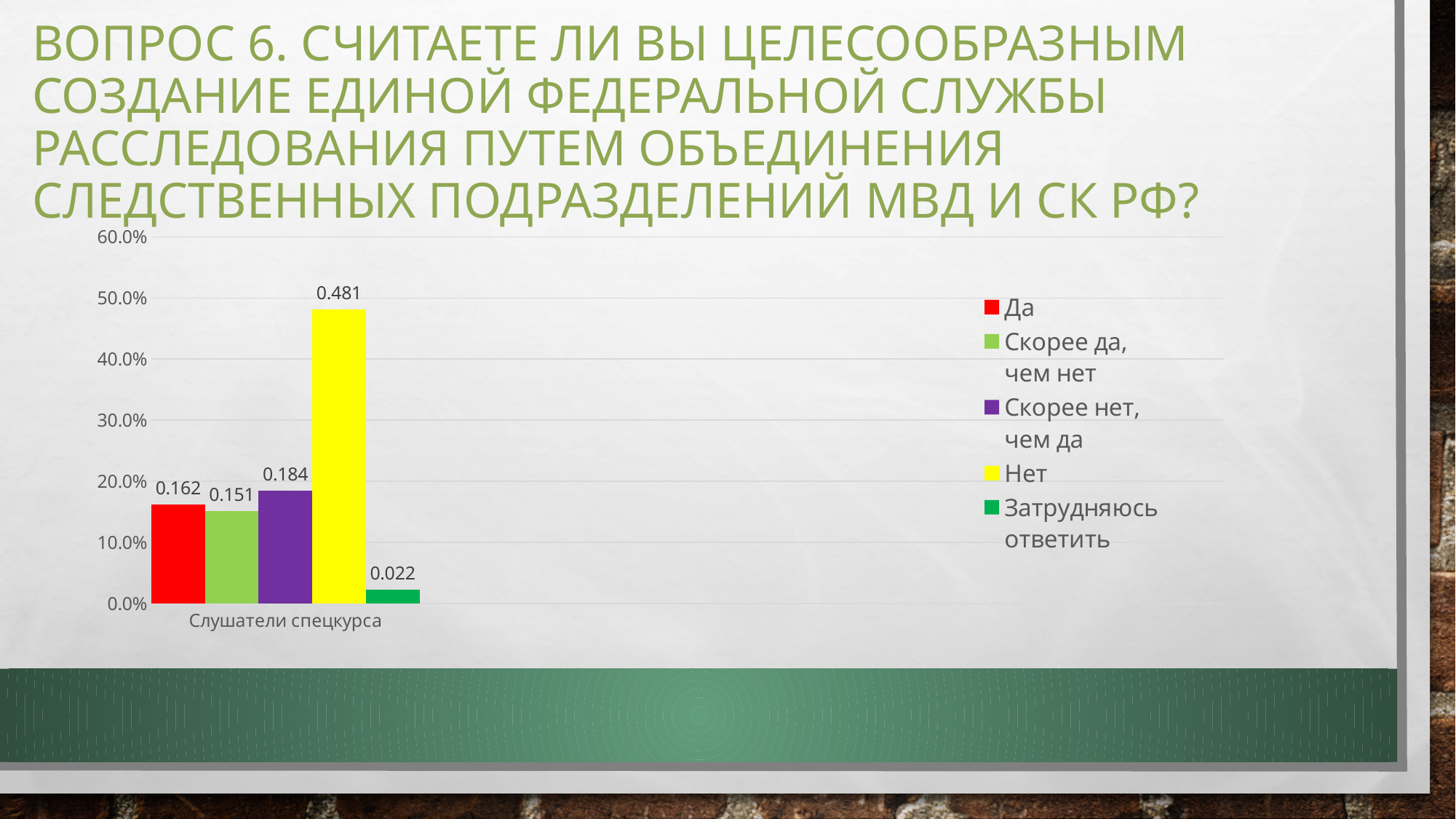
Which response has the lowest value? Затрудняюсь ответить Which response has the highest value? Нет How many series does the legend list? 5 What is the category label shown on the x axis? Слушатели спецкурса What is the value for "Скорее нет, чем да"? 0.184 What is the value for "Затрудняюсь ответить"? 0.022 What is the value for "Нет" among Слушатели спецкурса? 0.481 What kind of chart is shown on the slide? bar chart Is the value for "Нет" greater or less than 40.0%? greater Which is larger, the value for "Скорее нет, чем да" or the value for "Скорее да, чем нет"? Скорее нет, чем да What is the value for "Да" among Слушатели спецкурса? 0.162 What is the difference between the values for "Нет" and "Да"? 0.319